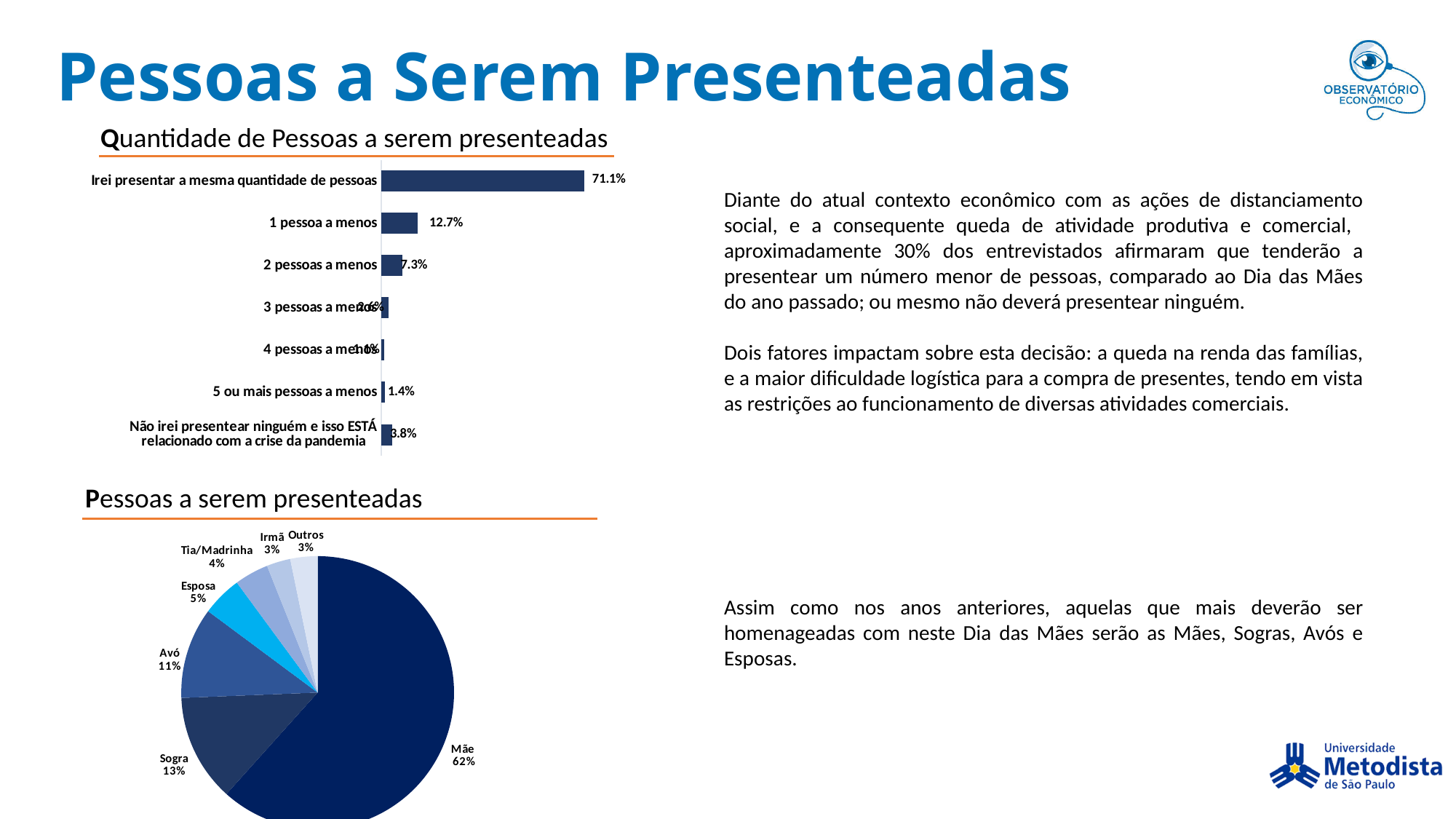
In the bar chart 'Quantidade de Pessoas a serem presenteadas', what is the value for 'Irei presentar a mesma quantidade de pessoas'? 71.1% In the bar chart 'Quantidade de Pessoas a serem presenteadas', how many categories are shown? 7 What type of chart is 'Quantidade de Pessoas a serem presenteadas'? Bar chart In the pie chart 'Pessoas a serem presenteadas', how many slices are there? 7 In the bar chart 'Quantidade de Pessoas a serem presenteadas', what is the value for '1 pessoa a menos'? 12.7% In the bar chart 'Quantidade de Pessoas a serem presenteadas', what is the value for 'Não irei presentear ninguém e isso ESTÁ relacionado com a crise da pandemia'? 3.8% In the bar chart 'Quantidade de Pessoas a serem presenteadas', which category has the highest value? Irei presentar a mesma quantidade de pessoas In the bar chart 'Quantidade de Pessoas a serem presenteadas', what is the value for '2 pessoas a menos'? 7.3% In the pie chart 'Pessoas a serem presenteadas', what is the value for 'Sogra'? 13% In the pie chart 'Pessoas a serem presenteadas', which is larger, 'Avó' or 'Esposa'? Avó In the pie chart 'Pessoas a serem presenteadas', what share does 'Mãe' have? 62% In the bar chart 'Quantidade de Pessoas a serem presenteadas', what is the difference between '1 pessoa a menos' and '2 pessoas a menos'? 5.4%